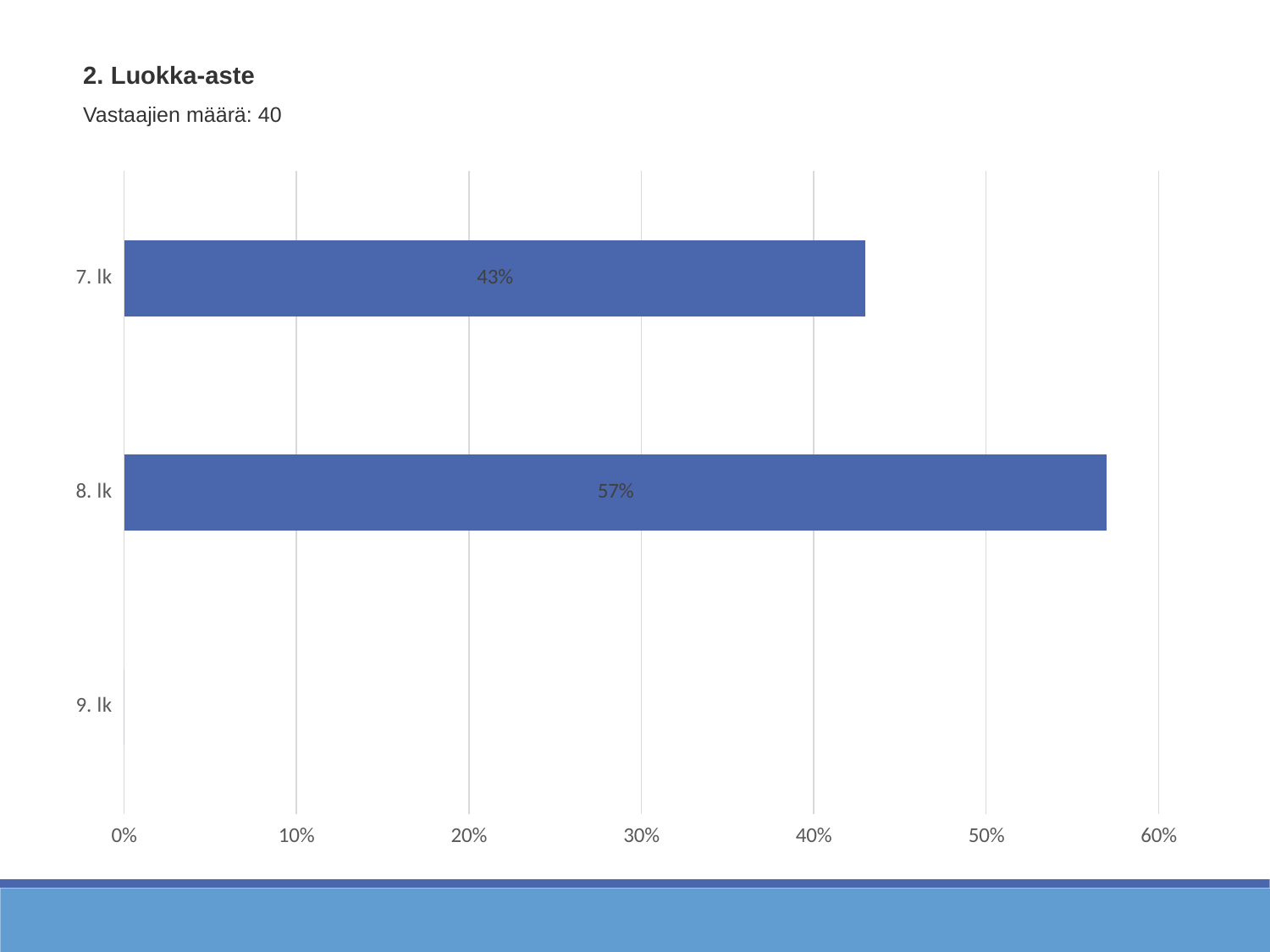
Which is larger, the value for 7. lk or the value for 8. lk? 8. lk What is the total of the values for 7. lk and 8. lk? 100% How many respondents does the slide report (Vastaajien määrä)? 40 Is the value for 7. lk greater or less than 40%? greater What is the difference between the values for 8. lk and 7. lk? 14% Which category has the highest value? 8. lk What is the title of the chart? 2. Luokka-aste Is the value for 8. lk greater or less than 60%? less What kind of chart is shown on the slide? bar chart What is the value for 8. lk? 57% What is the value for 7. lk? 43% How many categories are shown on the y axis? 3